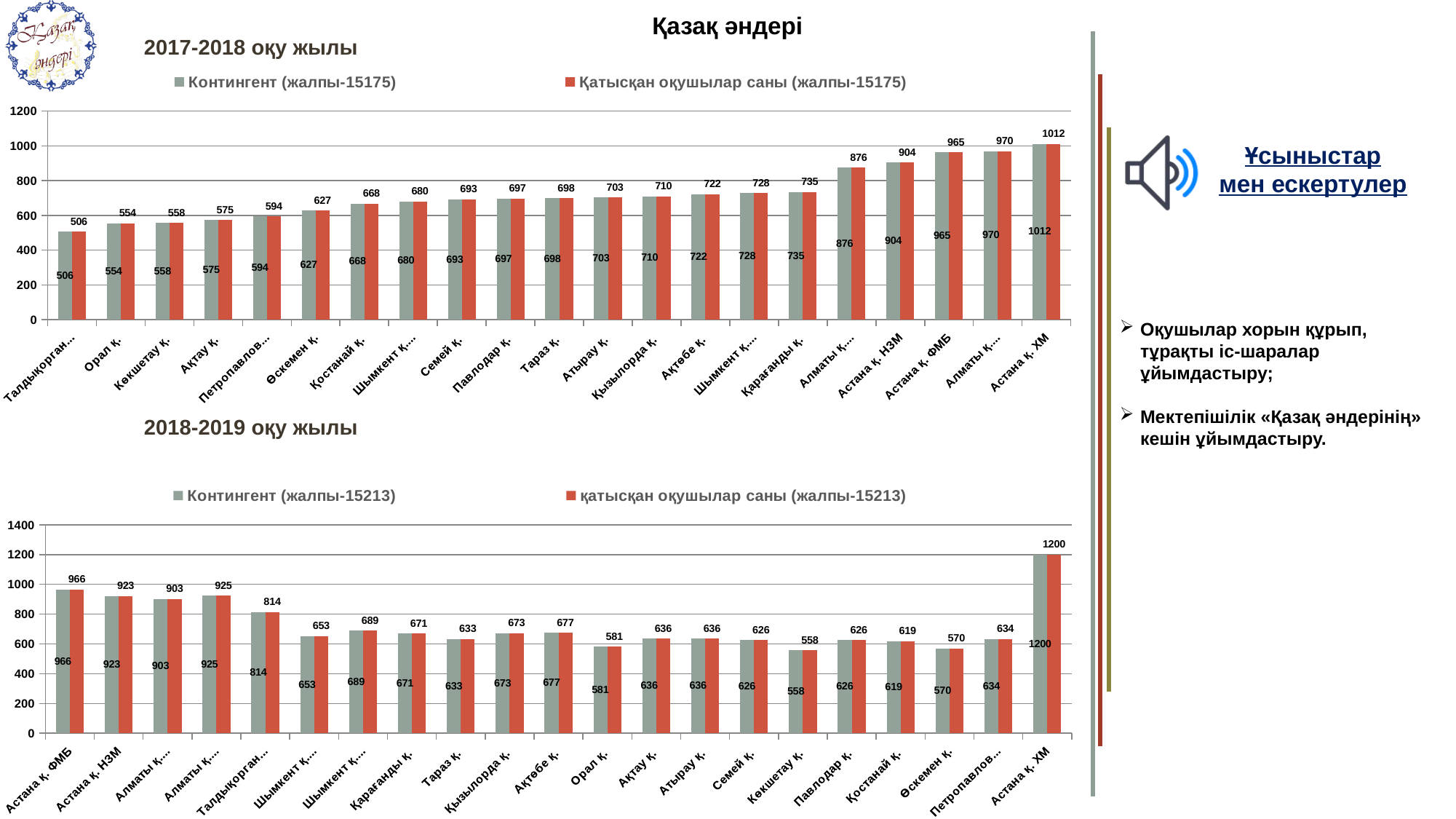
In the 2017-2018 оқу жылы chart, which category has the highest value? Астана қ. ХМ In the 2018-2019 оқу жылы chart, which is larger, the value for Тараз қ. or the value for Қызылорда қ.? Қызылорда қ. What kind of chart is the 2018-2019 оқу жылы chart? Bar chart In the 2018-2019 оқу жылы chart, what total is given in the legend entry for Контингент? 15213 In the 2018-2019 оқу жылы chart, is the value for Талдықорған... greater or less than 800? greater In the 2018-2019 оқу жылы chart, what is the value for Астана қ. ХМ? 1200 In the 2018-2019 оқу жылы chart, which category has the lowest value? Көкшетау қ. In the 2017-2018 оқу жылы chart, which category has the lowest value? Талдықорған... In the 2017-2018 оқу жылы chart, what is the difference between the values for Астана қ. ФМБ and Астана қ. НЗМ? 61 In the 2017-2018 оқу жылы chart, what is the Контингент value for Орал қ.? 554 In the 2017-2018 оқу жылы chart, how many series does the legend list? 2 In the 2018-2019 оқу жылы chart, how many categories are shown on the x axis? 21